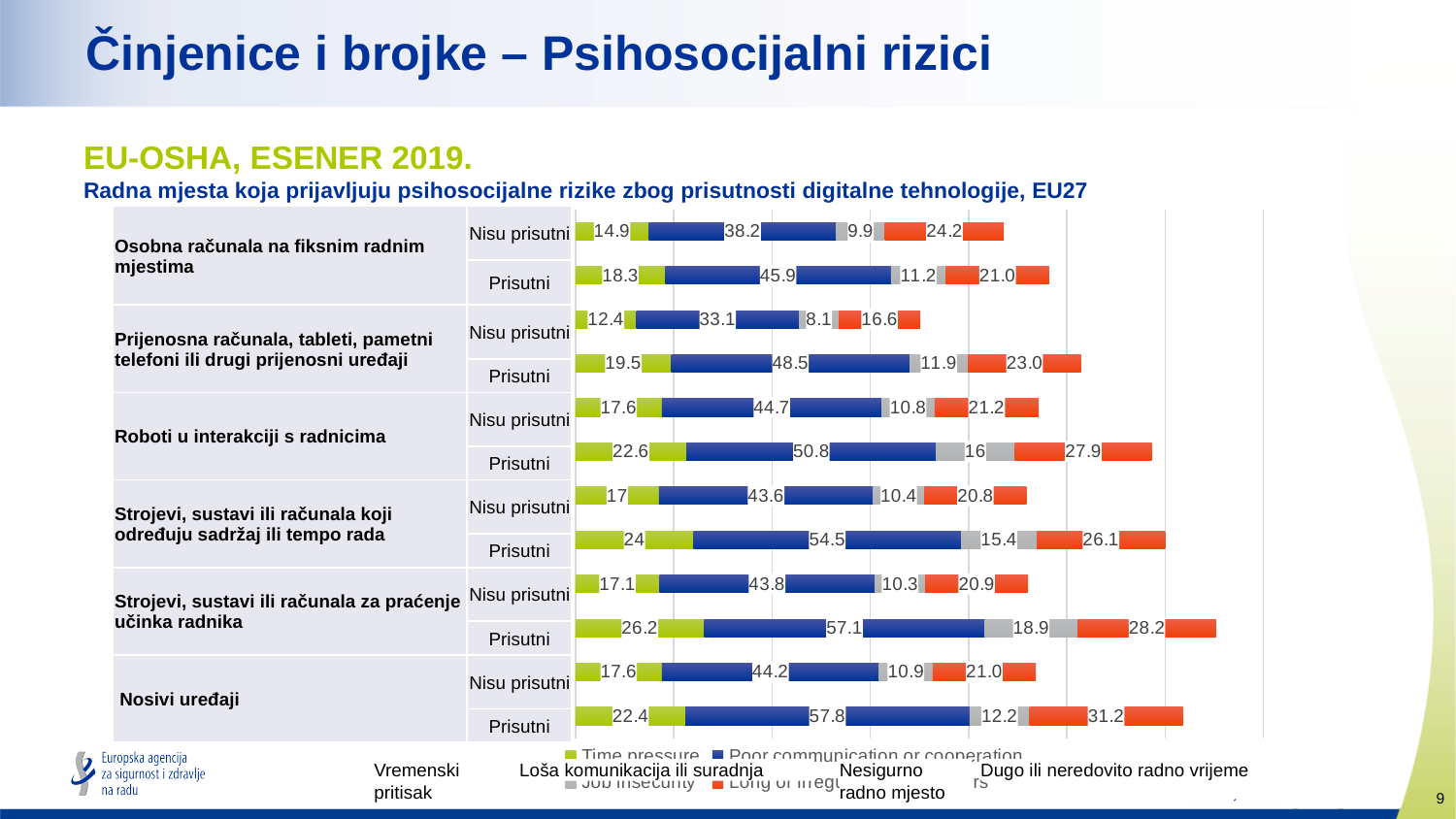
What is the total of the stacked bar for 'Prijenosna računala, tableti, pametni telefoni ili drugi prijenosni uređaji' in the 'Nisu prisutni' row? 70.2 What kind of chart is shown on the slide? Stacked bar chart How many series does the legend list? 4 Which bar has the lowest Time pressure value? Prijenosna računala, tableti, pametni telefoni ili drugi prijenosni uređaji, Nisu prisutni (12.4) How many bars are plotted in the chart? 12 For 'Nosivi uređaji', is the Long or irregular working hours value larger in the 'Prisutni' row or the 'Nisu prisutni' row? Prisutni For 'Osobna računala na fiksnim radnim mjestima', what is the difference in Poor communication or cooperation between the 'Prisutni' and 'Nisu prisutni' rows? 7.7 Which bar has the highest Poor communication or cooperation value? Nosivi uređaji, Prisutni (57.8) What is the Poor communication or cooperation value for 'Roboti u interakciji s radnicima' in the 'Nisu prisutni' row? 44.7 What is the Job insecurity value for 'Strojevi, sustavi ili računala za praćenje učinka radnika' in the 'Prisutni' row? 18.9 What is the Time pressure value for 'Osobna računala na fiksnim radnim mjestima' in the 'Prisutni' row? 18.3 What is the Long or irregular working hours value for 'Nosivi uređaji' in the 'Prisutni' row? 31.2